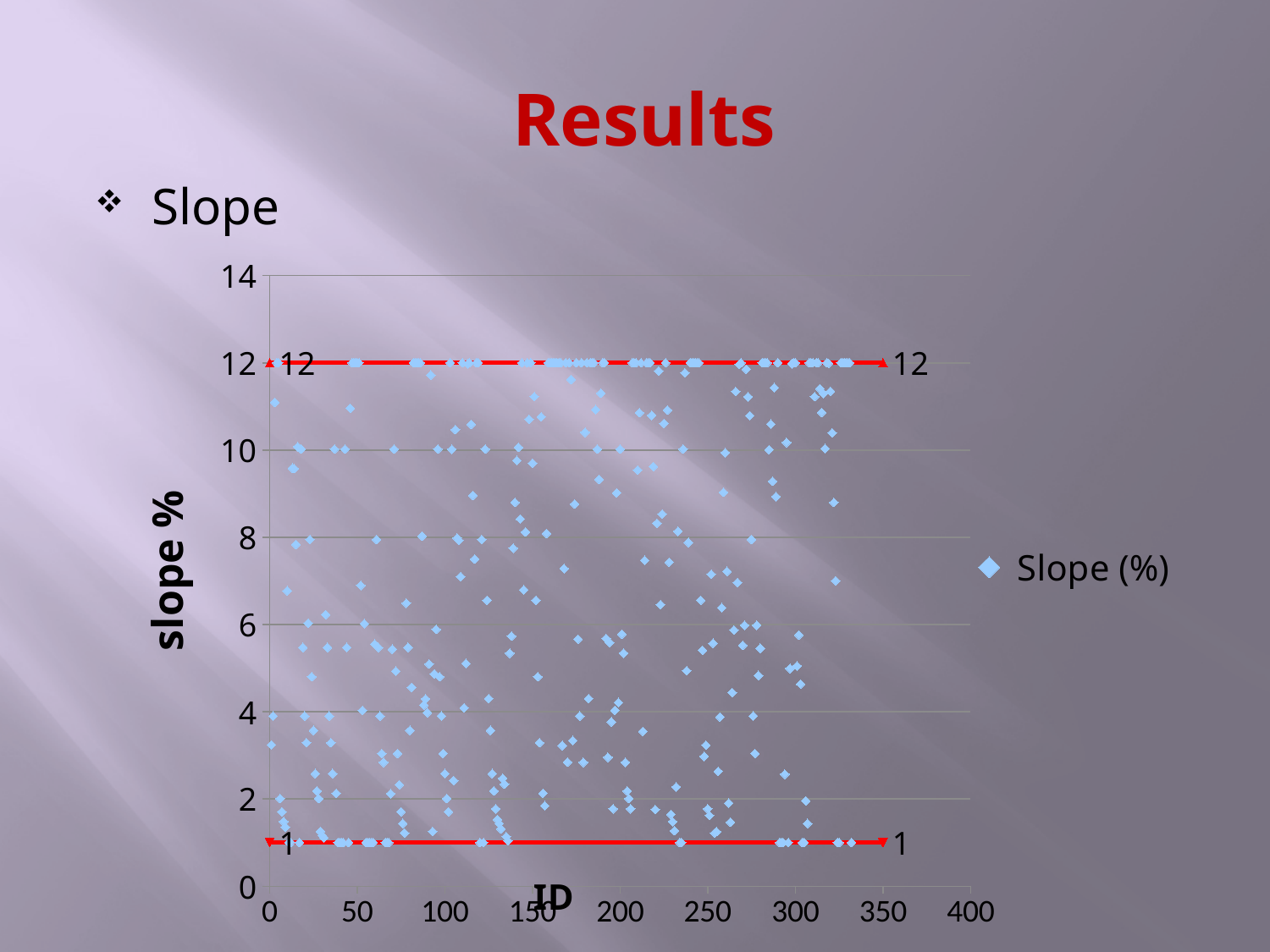
What is the lowest slope % value marked on the chart? 1 What is the name of the series shown in the chart legend? Slope (%) Is the value of the upper red line greater or less than 10? greater What is the difference between the values of the upper and lower red lines? 11 What value is labelled on the lower red horizontal line in the chart? 1 Which red line has the larger value, the upper one or the lower one? the upper one What is the maximum value shown on the vertical axis of the chart? 14 What value is labelled on the upper red horizontal line in the chart? 12 What is the title of the vertical axis of the chart? slope % What kind of chart is shown on the slide? scatter chart What is the highest slope % value marked on the chart? 12 How many series does the chart legend list? 1